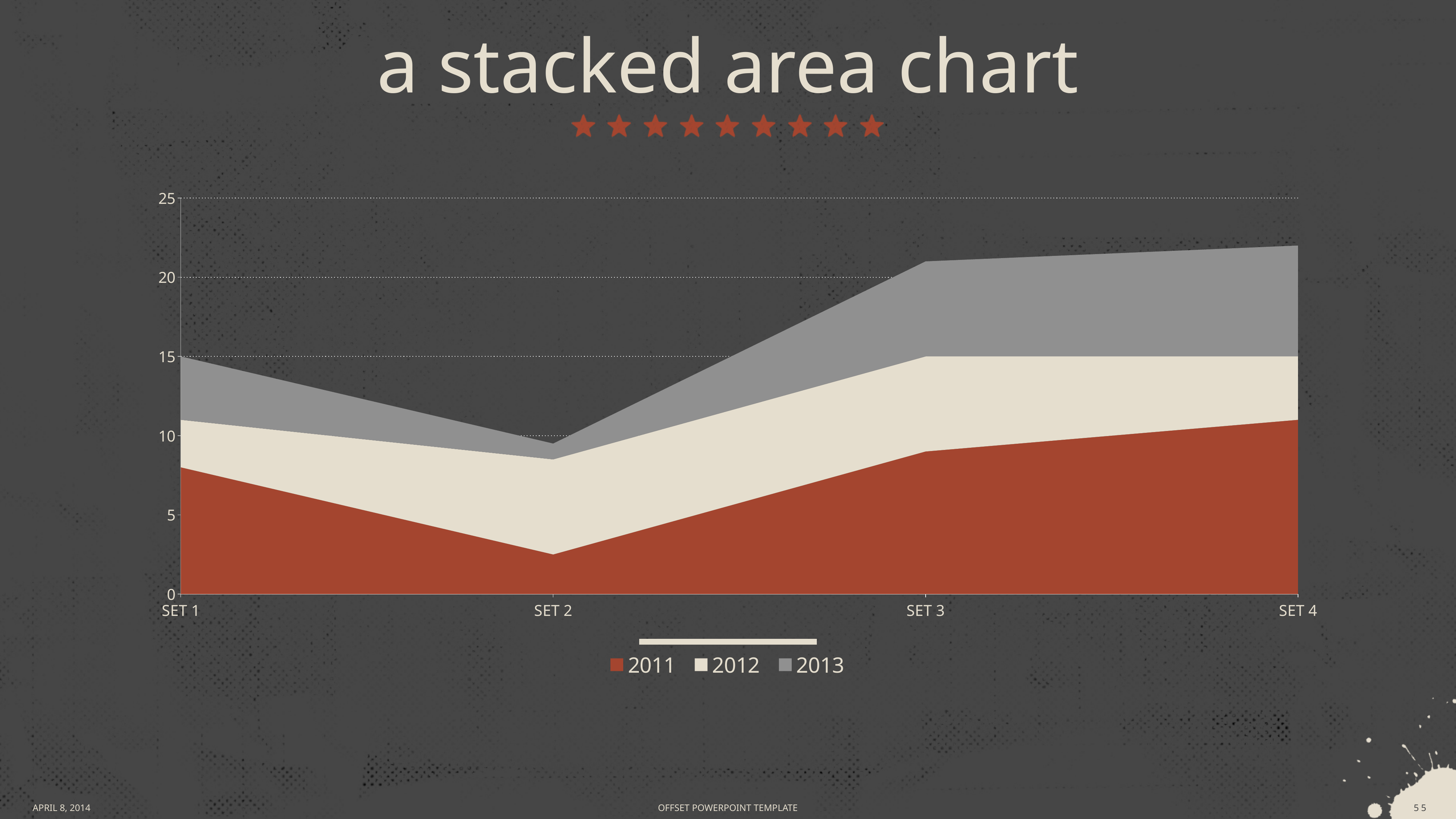
Is the value for 2011 at SET 4 greater or less than 10? greater For the 2011 series, which category has the highest value? SET 4 Is the value for 2011 at SET 1 greater or less than 10? less What kind of chart is shown on the slide? stacked area chart Is the stacked total at SET 3 greater or less than 20? greater For the 2011 series, which category has the lowest value? SET 2 How many categories are shown on the x axis? 4 What is the title of the chart slide? a stacked area chart Which series are listed in the legend? 2011, 2012, 2013 How many series does the legend list? 3